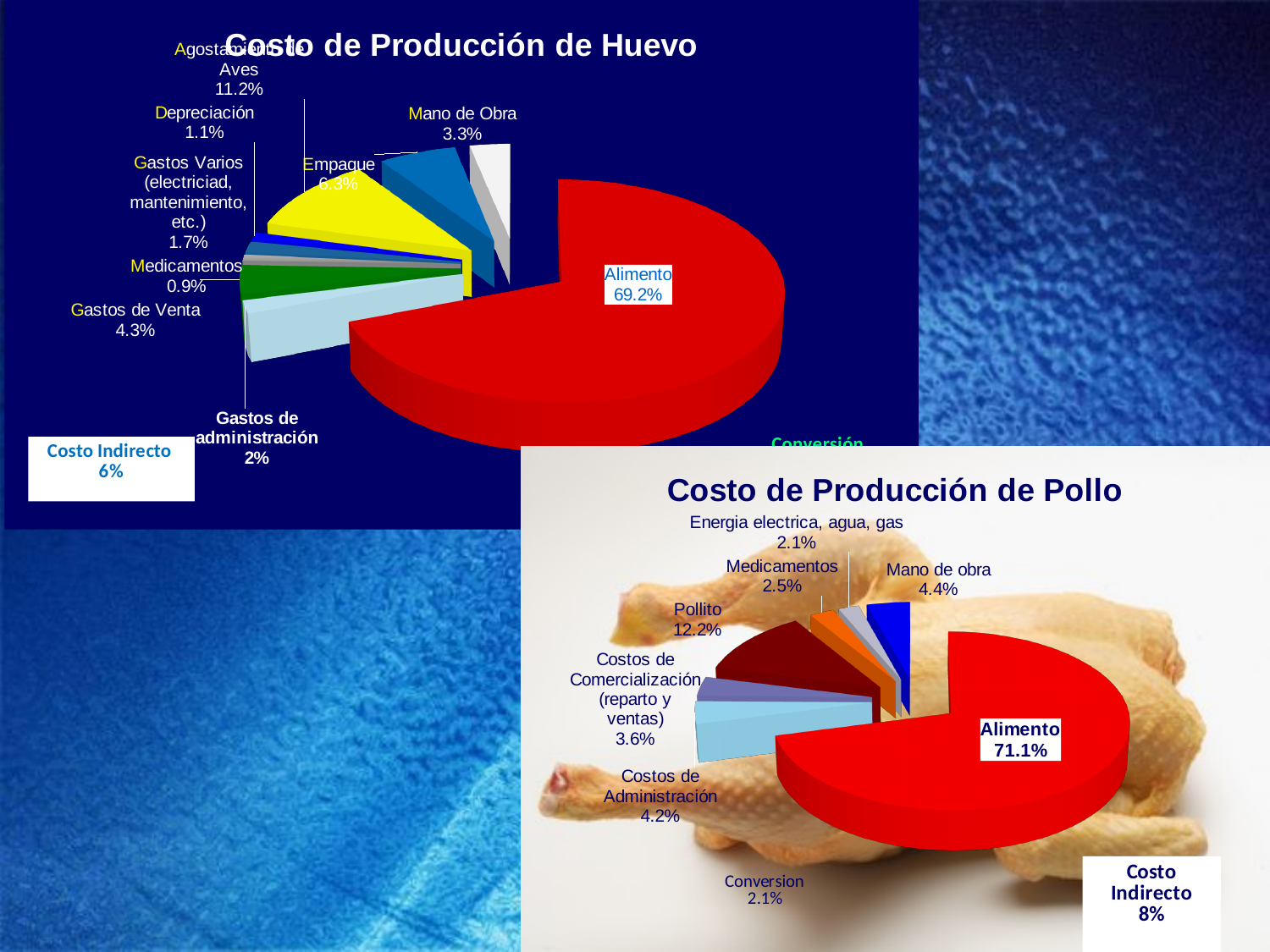
In the 'Costo de Producción de Huevo' chart, which is larger, Mano de Obra or Depreciación? Mano de Obra In the 'Costo de Producción de Huevo' chart, which category has the smallest share? Medicamentos In the 'Costo de Producción de Huevo' chart, what is the difference between Gastos de Venta and Mano de Obra? 1.0% What type of chart is 'Costo de Producción de Pollo'? Pie chart In the 'Costo de Producción de Huevo' chart, what is the value for Gastos de Venta? 4.3% What is the Costo Indirecto value shown next to the 'Costo de Producción de Pollo' chart? 8% In the 'Costo de Producción de Pollo' chart, which category has the largest share? Alimento In the 'Costo de Producción de Pollo' chart, what is the value for Pollito? 12.2% In the 'Costo de Producción de Pollo' chart, what is the difference between Mano de obra and Costos de Administración? 0.2% In the 'Costo de Producción de Pollo' chart, how many slices are labeled? 7 In the 'Costo de Producción de Pollo' chart, what share does Alimento represent? 71.1% In the 'Costo de Producción de Huevo' chart, what share does Alimento represent? 69.2%